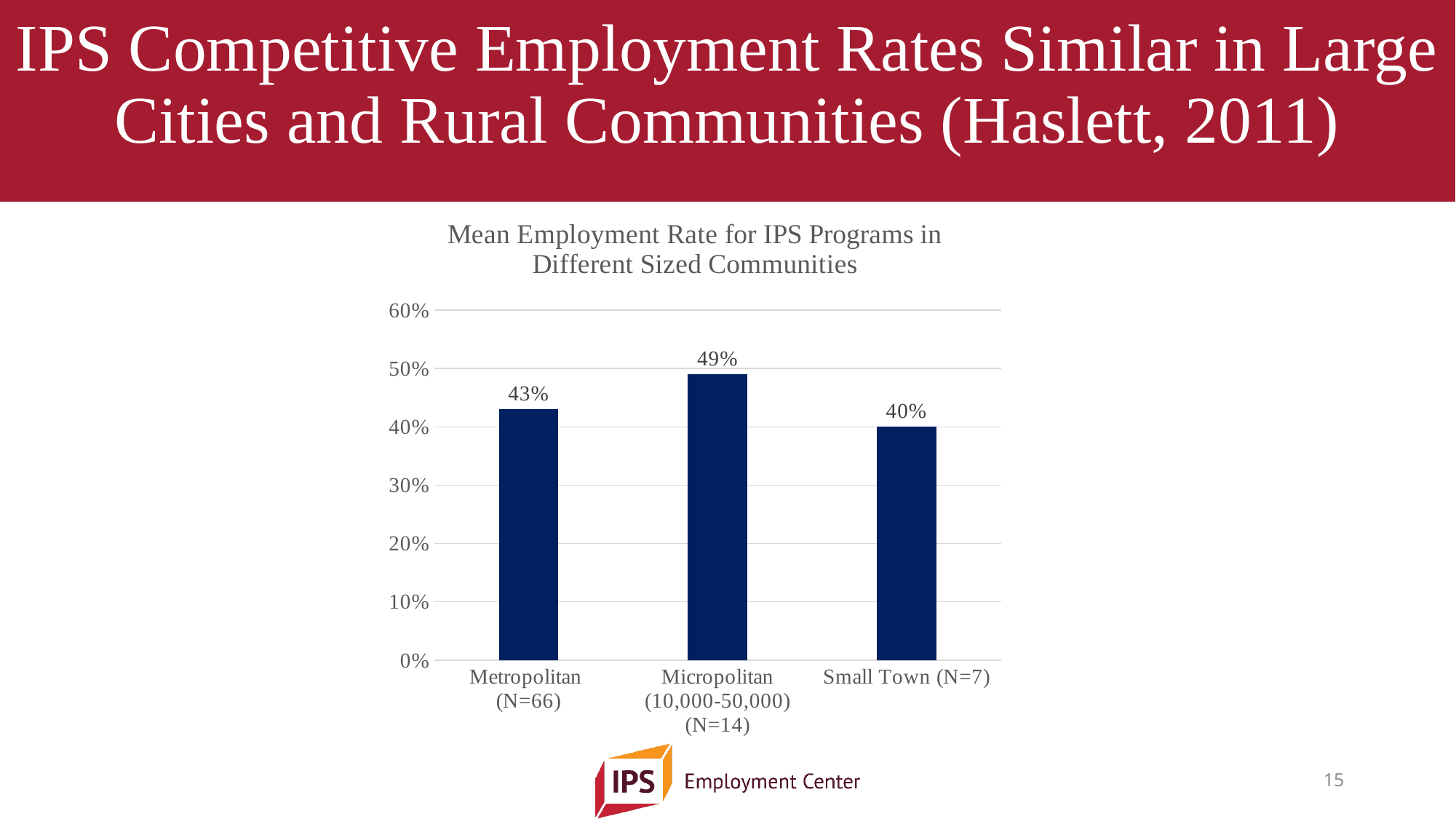
What type of chart is shown on the slide? Bar chart Which community size has the lowest mean employment rate? Small Town (N=7) What is the mean employment rate for Micropolitan (10,000-50,000) (N=14) programs? 49% What is the difference between the Micropolitan and Metropolitan mean employment rates? 6% What is the mean employment rate for Metropolitan (N=66) programs? 43% How many community size categories are shown in the chart? 3 Which community size has the highest mean employment rate? Micropolitan (10,000-50,000) (N=14) What is the difference between the Metropolitan and Small Town mean employment rates? 3% What is the mean employment rate for Small Town (N=7) programs? 40% Is the value for Micropolitan greater or less than 40%? greater What is the title of the chart? Mean Employment Rate for IPS Programs in Different Sized Communities Which has a higher mean employment rate, Metropolitan or Small Town? Metropolitan